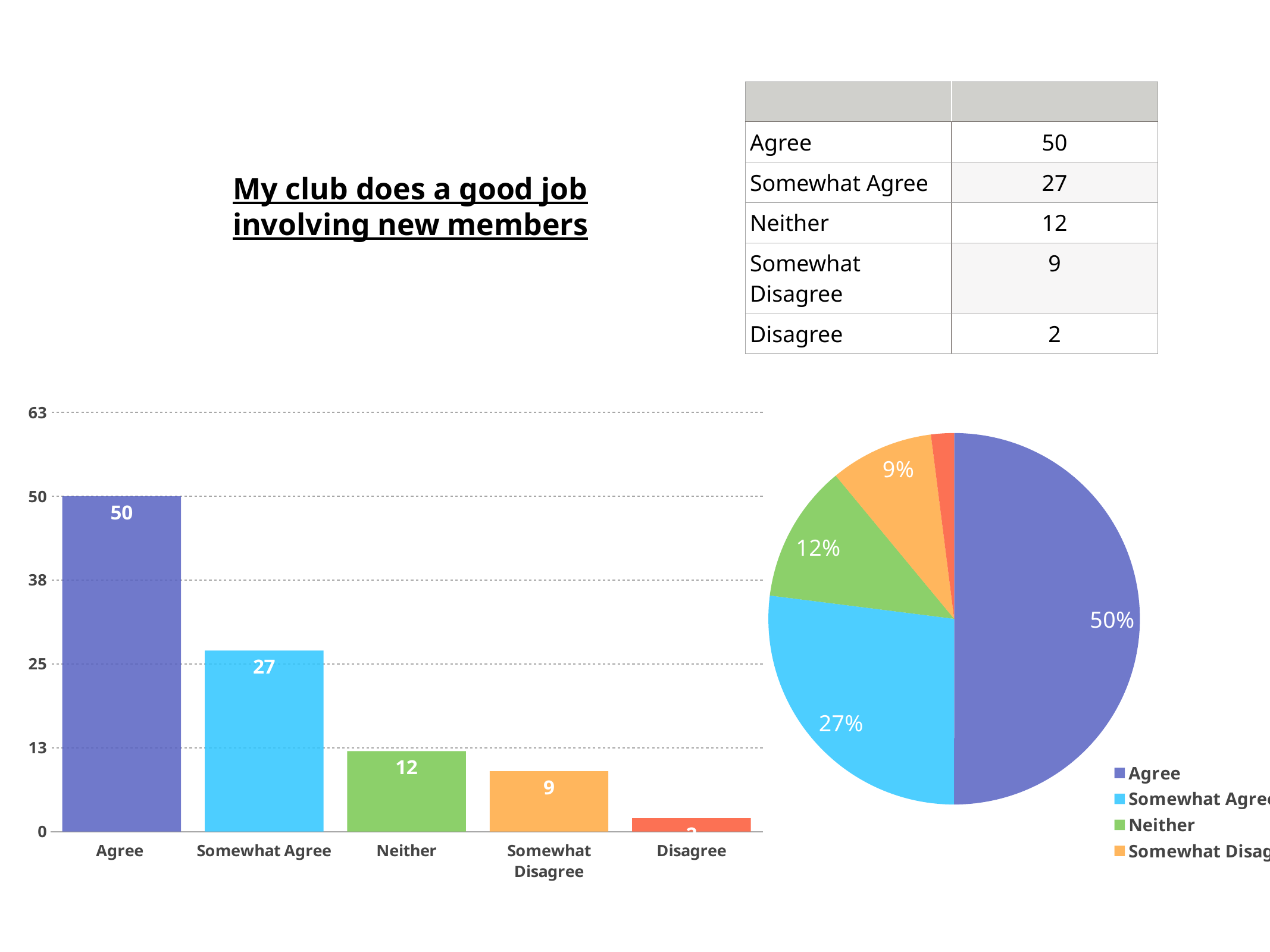
In the bar chart, which category has the highest value? Agree In the bar chart, which category has the lowest value? Disagree In the bar chart, what is the difference between the values for Agree and Somewhat Agree? 23 In the bar chart, what is the value for Agree? 50 What kind of chart is the chart on the left of the slide? bar chart In the bar chart, what is the value for Somewhat Disagree? 9 In the pie chart, what share does the Neither slice represent? 12% How many categories are shown in the bar chart? 5 In the bar chart, do the values rise or fall from left to right along the x axis? fall In the bar chart, what is the value for Neither? 12 In the bar chart, is the value for Disagree greater or less than 13? less In the bar chart, what is the value for Somewhat Agree? 27